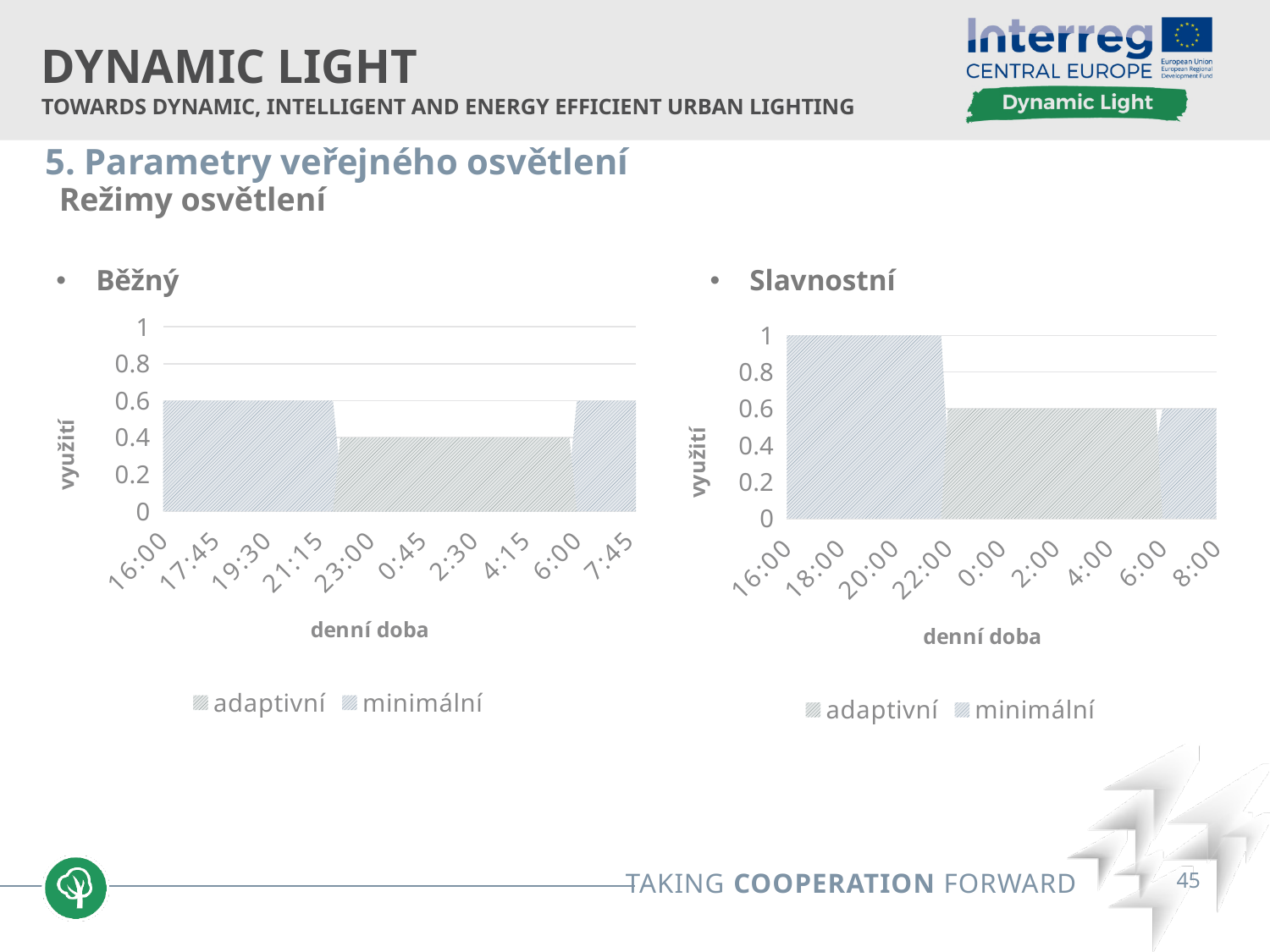
How many series does the legend of the Slavnostní chart list? 2 In the Slavnostní chart, do the values rise or fall from 16:00 to 8:00? fall In the Slavnostní chart, which is larger, the value at 18:00 or the value at 2:00? 18:00 In the Slavnostní chart, what value does the plotted area reach at 16:00? 1 In the Slavnostní chart, what value does the plotted area have at 0:00? 0.6 What kind of chart is the Běžný chart on the left? area chart In the Běžný chart, what value does the plotted area reach at 16:00? 0.6 What are the two legend entries of the Běžný chart? adaptivní, minimální In the Běžný chart, is the value at 2:30 greater or less than 0.6? less What is the y-axis title of the Slavnostní chart? využití In the Slavnostní chart, is the value at 18:00 greater or less than 0.8? greater In the Běžný chart, what value does the plotted area have at 0:45? 0.4